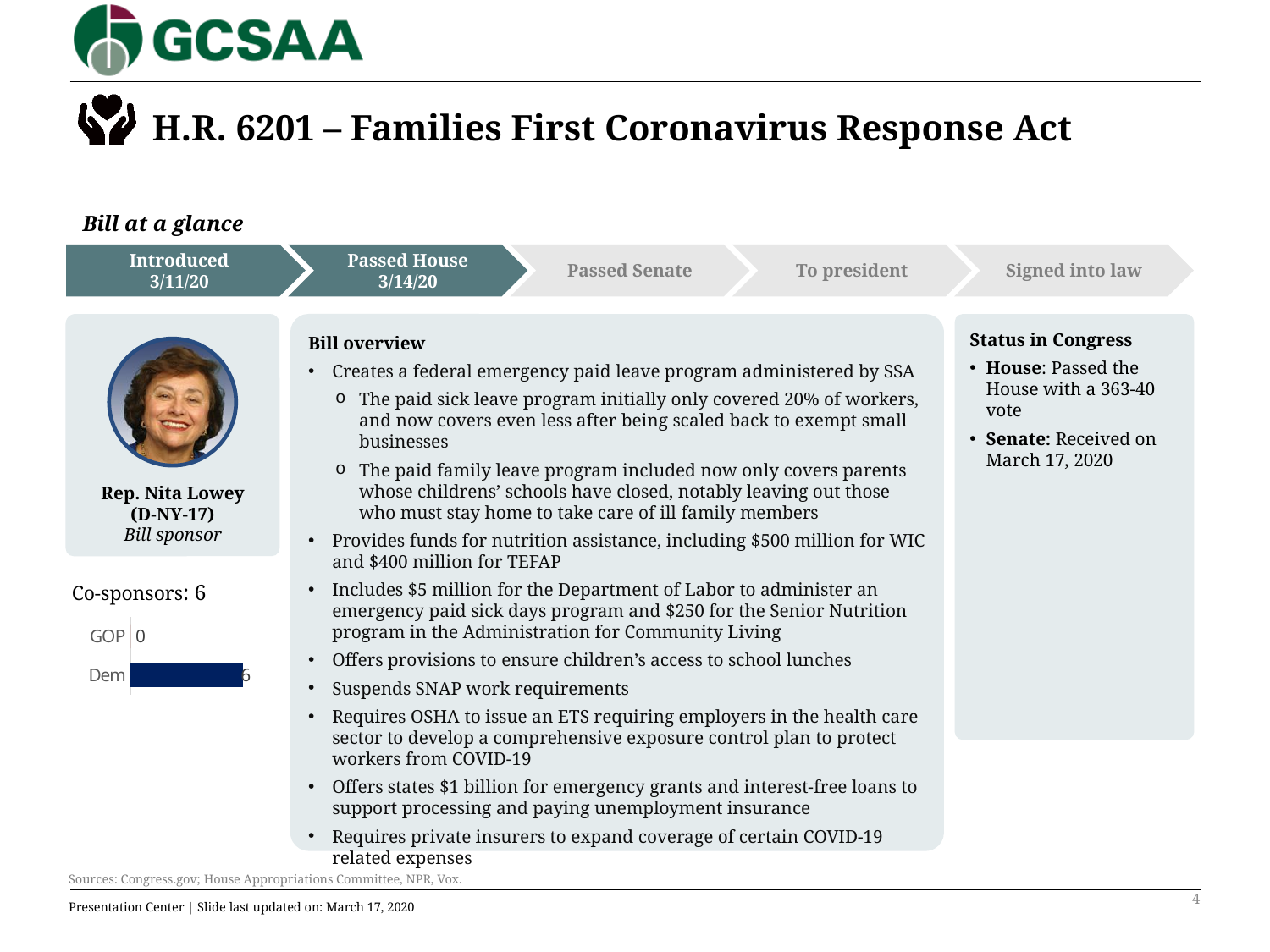
What kind of chart is the co-sponsors chart? bar chart In the co-sponsors chart, how many co-sponsors are Dem? 6 Are the bars in the co-sponsors chart horizontal or vertical? horizontal In the co-sponsors chart, which party has the lower number of co-sponsors? GOP How many categories does the co-sponsors chart show? 2 What is the total number of co-sponsors shown above the chart? 6 In the co-sponsors chart, is the value for Dem larger or smaller than the value for GOP? larger What is the heading printed above the co-sponsors bar chart? Co-sponsors: 6 In the co-sponsors chart, which party has the higher number of co-sponsors? Dem In the co-sponsors chart, how many co-sponsors are GOP? 0 In the co-sponsors chart, what is the difference between the Dem and GOP co-sponsor counts? 6